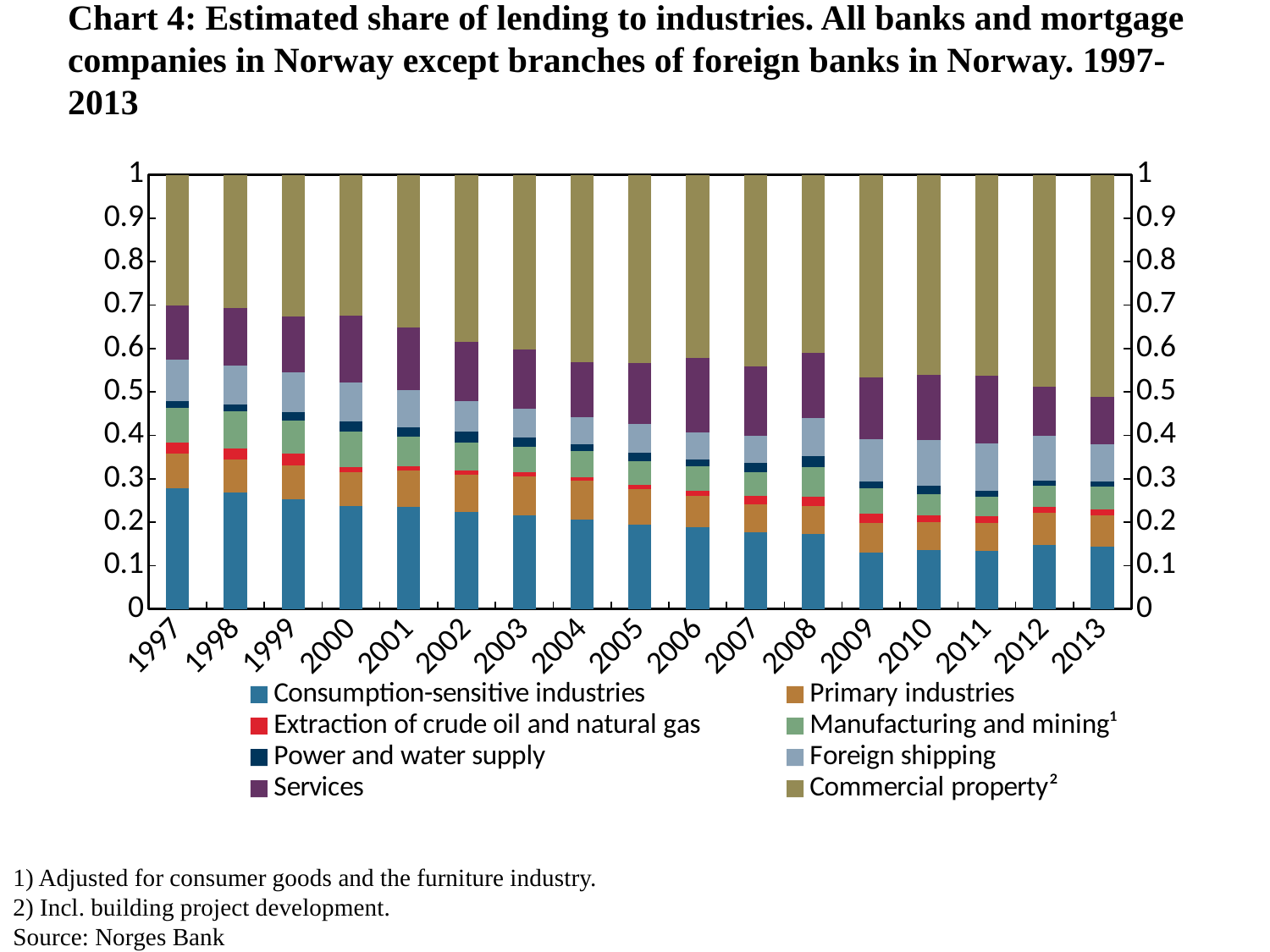
Does the share of Consumption-sensitive industries generally rise or fall from 1997 to 2013? Fall Which is larger, the Consumption-sensitive industries share in 1997 or in 2013? 1997 What is the total of the stacked bar for 2005? 1 What is the source given for the chart? Norges Bank Is the value for Consumption-sensitive industries in 1997 greater or less than 0.2? greater Is the value for Consumption-sensitive industries in 2013 greater or less than 0.2? less How many years are shown along the x axis of the chart? 17 How many series does the legend list? 8 What kind of chart is shown on the slide? Stacked bar chart Does the share of Commercial property generally rise or fall from 1997 to 2013? Rise Is the value for Consumption-sensitive industries in 2009 greater or less than 0.1? greater Which series is shown in red in the legend? Extraction of crude oil and natural gas